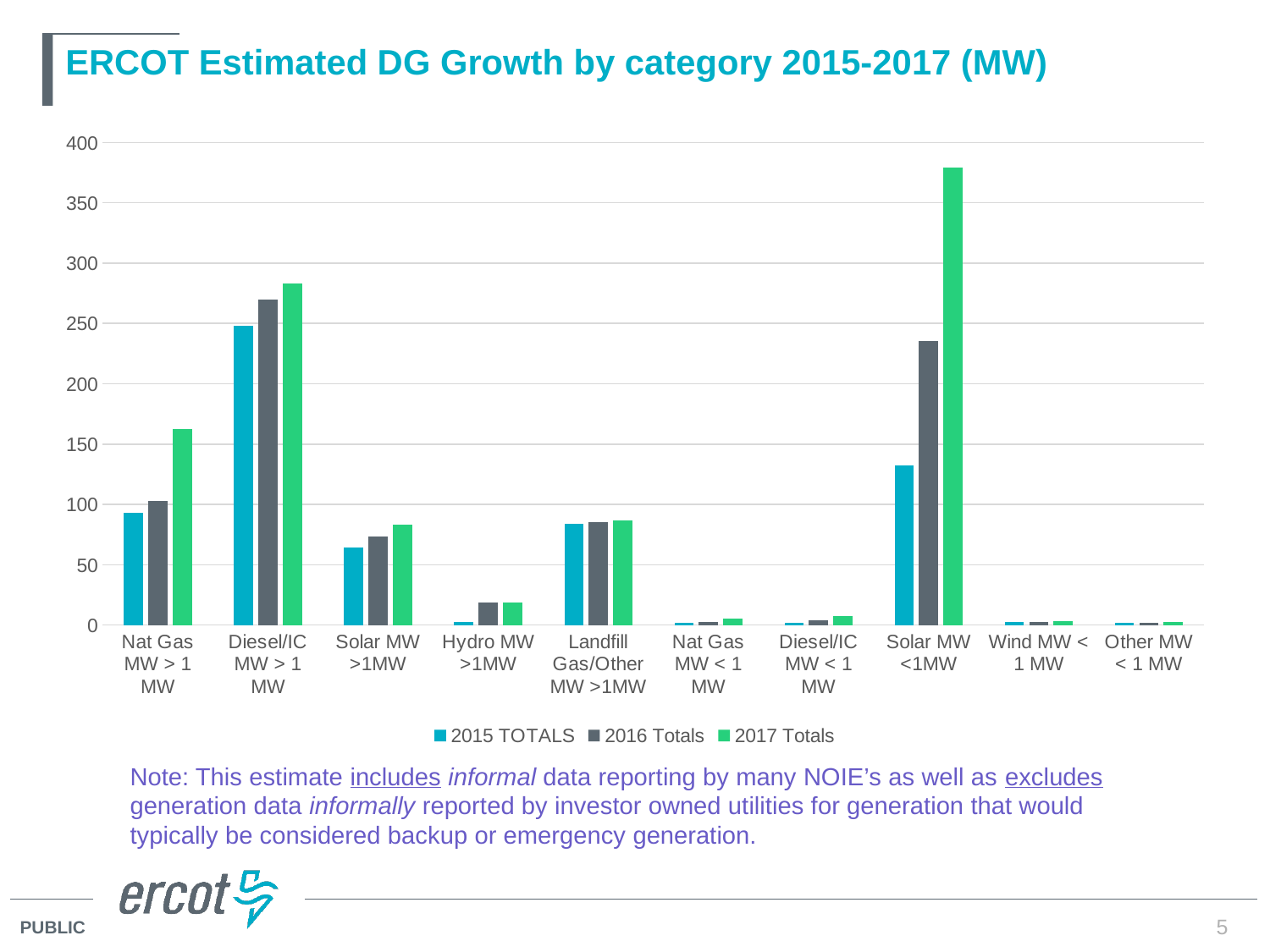
Is the 2017 Totals value for Solar MW <1MW greater or less than 350? greater Which is larger for 2016 Totals: Diesel/IC MW > 1 MW or Solar MW <1MW? Diesel/IC MW > 1 MW Is the 2015 TOTALS value for Solar MW >1MW greater or less than 100? less What is the title of the chart? ERCOT Estimated DG Growth by category 2015-2017 (MW) How many series does the legend list? 3 How many categories are shown along the x axis? 10 Which category has the highest 2015 TOTALS value? Diesel/IC MW > 1 MW Is the 2015 TOTALS value for Diesel/IC MW > 1 MW greater or less than 200? greater Do the values for Solar MW <1MW rise or fall from 2015 to 2017? rise Which category has the highest 2017 Totals value? Solar MW <1MW What kind of chart is shown on the slide? Bar chart